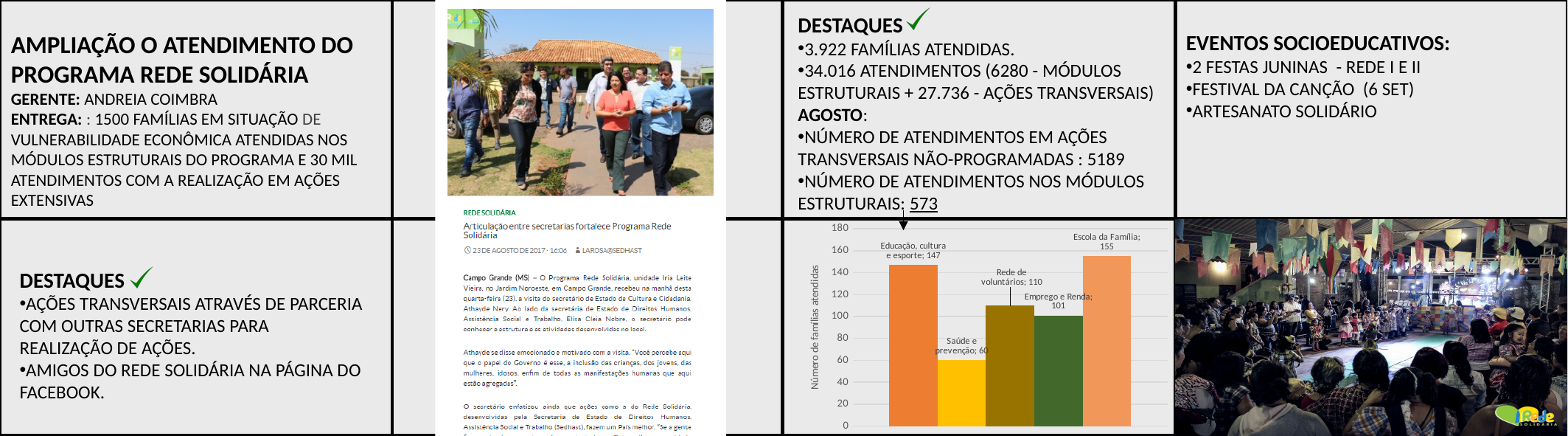
What is the value for Rede de voluntários? 110 What is the value for Emprego e Renda? 101 How many categories are shown in the chart? 5 What is the label of the vertical axis of the chart? Número de famílias atendidas Which category has the lowest value? Saúde e prevenção What is the value for Escola da Família? 155 Which is larger, Rede de voluntários or Emprego e Renda? Rede de voluntários What is the value for Saúde e prevenção? 60 What is the value for Educação, cultura e esporte? 147 What kind of chart is shown on the slide? Bar chart Which category has the highest value? Escola da Família What is the difference between Escola da Família and Educação, cultura e esporte? 8